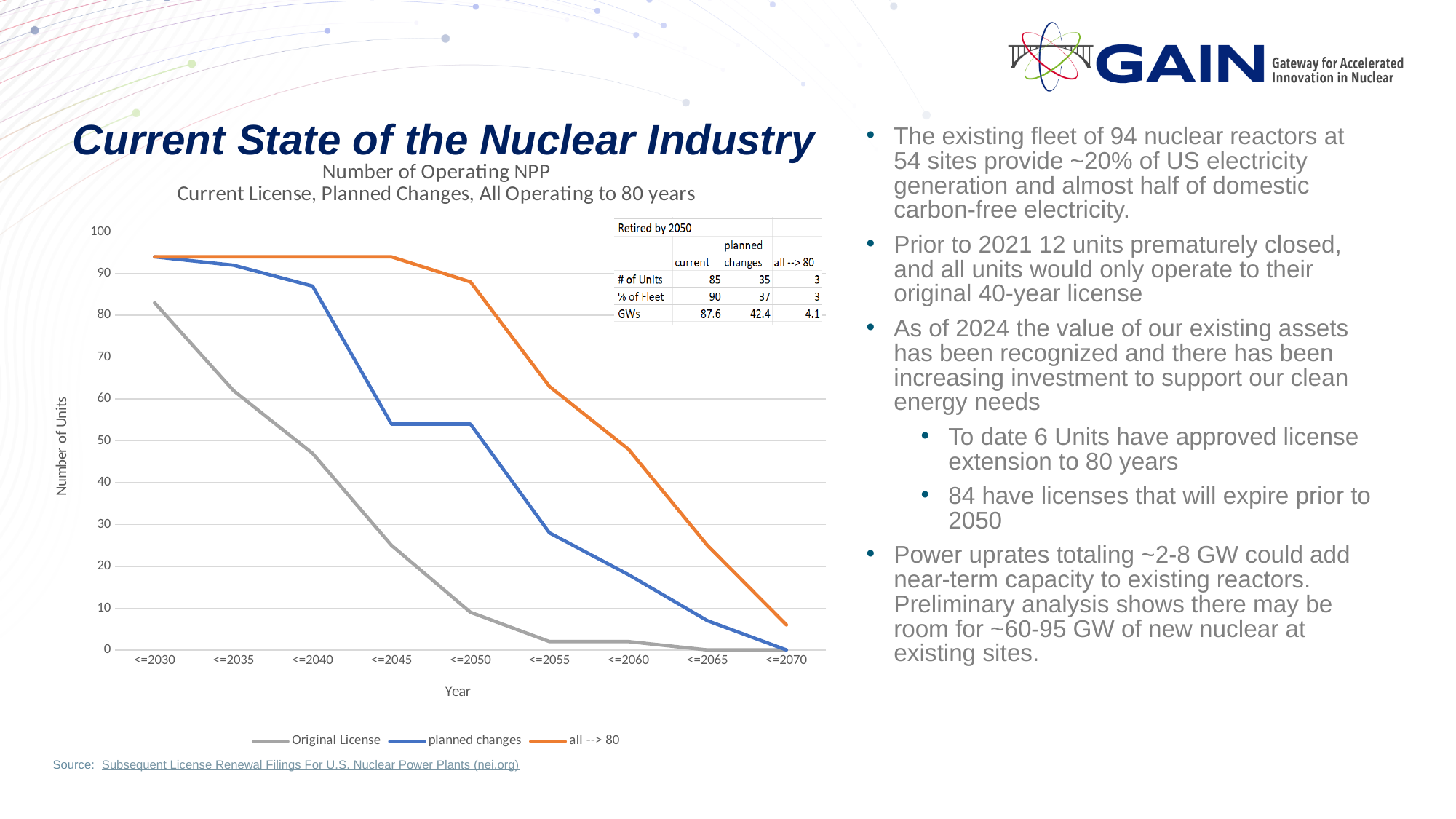
Which series has the lowest value at <=2040? Original License Which series has the highest value at <=2060? all --> 80 What kind of chart is shown on the slide? line chart At <=2050, which series has the larger value: 'planned changes' or 'all --> 80'? all --> 80 How many series does the chart legend list? 3 What colour is the 'all --> 80' line in the chart? orange Is the value for 'Original License' at <=2045 greater or less than 20? greater Is the value for 'all --> 80' at <=2050 greater or less than 80? greater Do the values of the 'all --> 80' series rise or fall along the x axis from <=2030 to <=2070? fall How many year categories are shown on the x axis of the chart? 9 Is the value for 'Original License' at <=2055 greater or less than 10? less